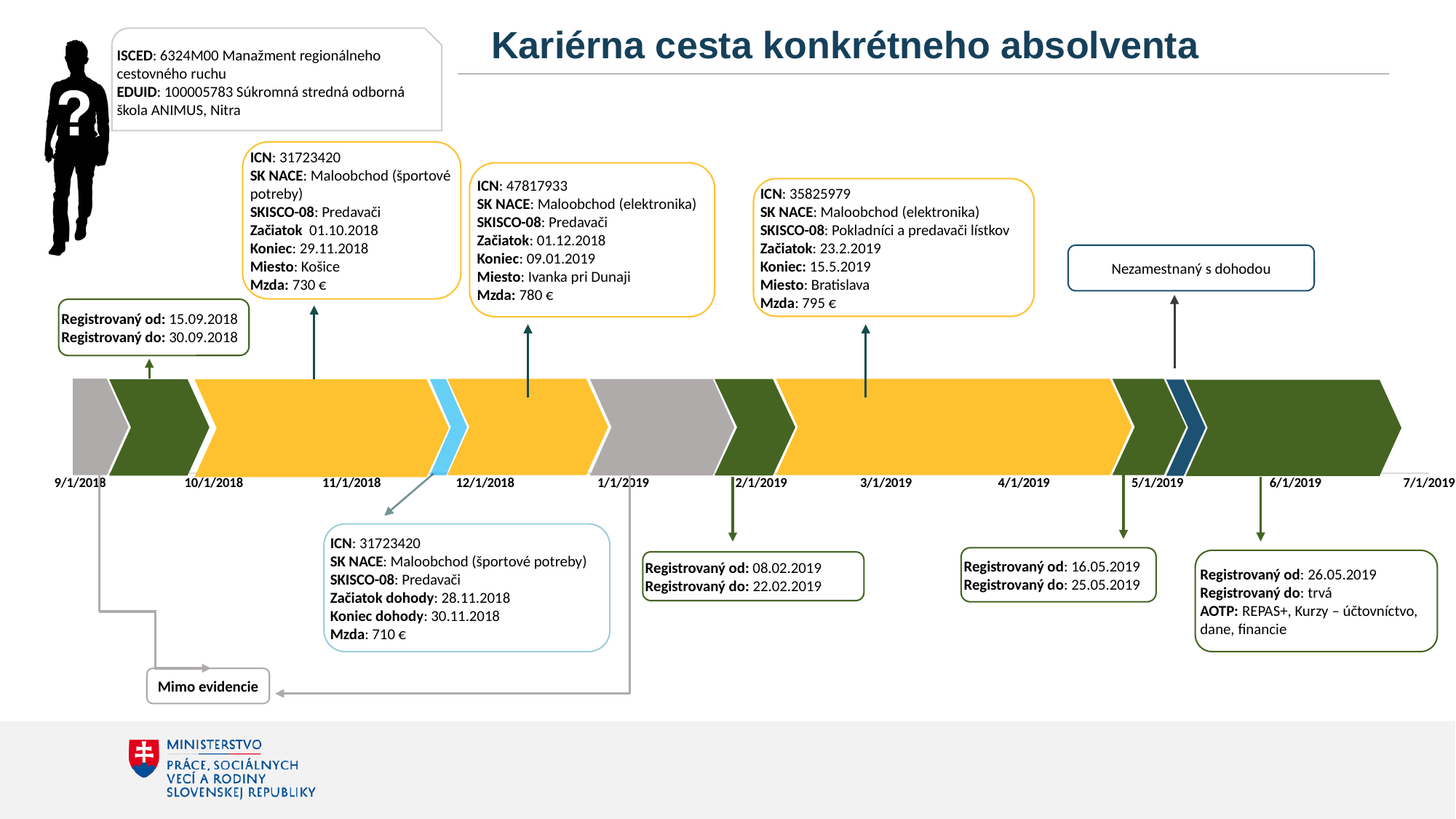
On the timeline, what is the Mzda shown for the job with ICN 35825979 in Bratislava? 795 € Which job on the timeline has the highest Mzda? ICN 35825979 (Bratislava), 795 € How many date labels are shown along the timeline axis? 11 Do the wages of the three main jobs (Košice, Ivanka pri Dunaji, Bratislava) rise or fall over time along the timeline? Rise What label is shown in the box above the dark blue segment of the timeline? Nezamestnaný s dohodou On the timeline, what is the Mzda (wage) shown for the job with ICN 47817933? 780 € What is the title of the slide's timeline chart? Kariérna cesta konkrétneho absolventa What is the Miesto (place) for the job with ICN 35825979? Bratislava Which job has the higher Mzda: the one in Košice or the one in Ivanka pri Dunaji? Ivanka pri Dunaji What is the difference between the Mzda of the Bratislava job (795 €) and the Košice job (730 €)? 65 € What kind of chart is shown on the slide? Timeline chart Which job on the timeline has the lowest Mzda? The dohoda job (ICN 31723420, 28.11.2018–30.11.2018), 710 €